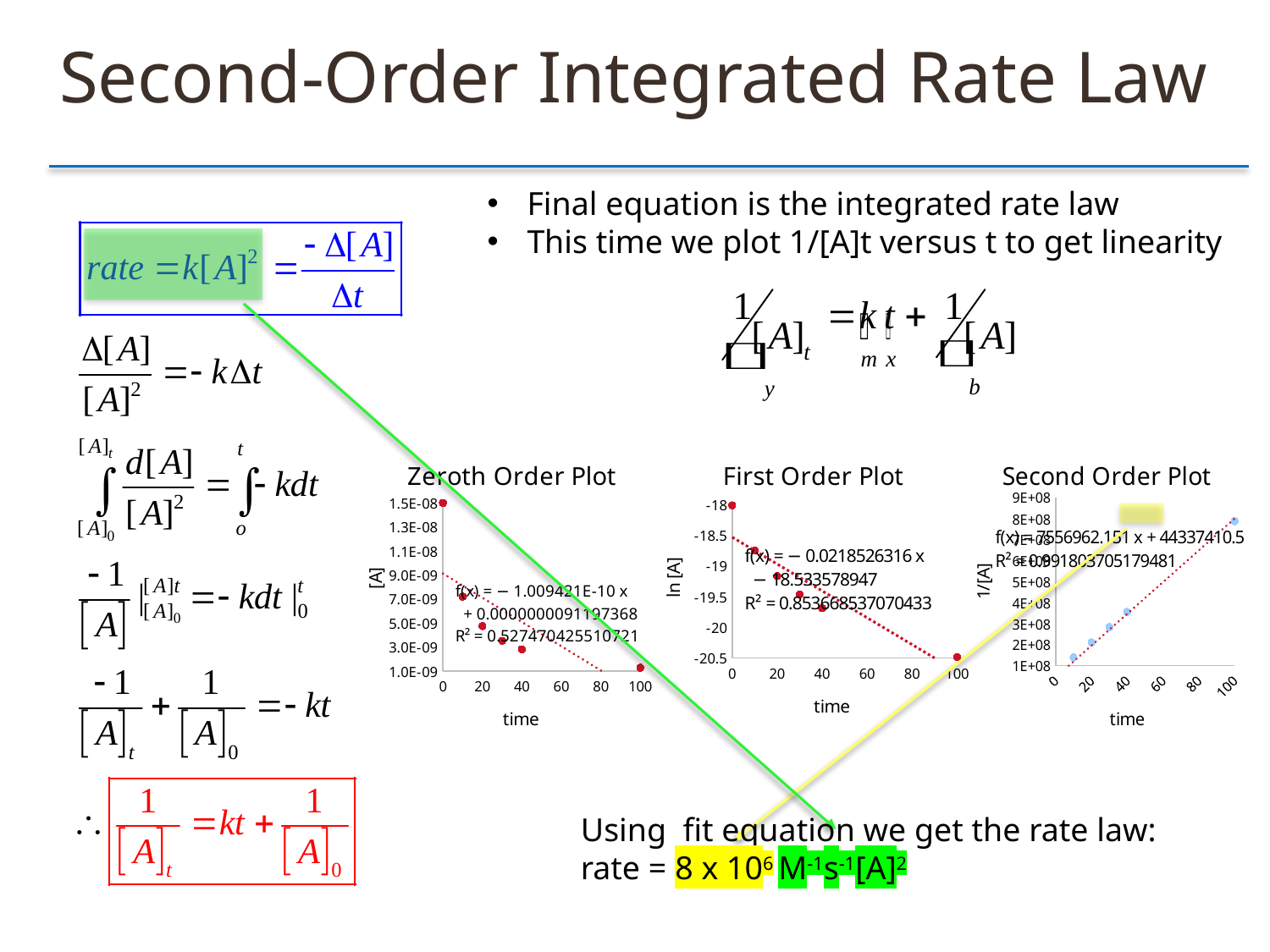
In the First Order Plot, do the ln [A] values rise or fall as time increases? fall In the Second Order Plot, at which time is 1/[A] highest? 100 In the First Order Plot, is the value at time 100 greater or less than -20? less What kind of chart is the Zeroth Order Plot? scatter plot In the Zeroth Order Plot, at which time is [A] highest? 0 In the Zeroth Order Plot, do the [A] values rise or fall as time increases? fall In the Second Order Plot, is the value at time 100 greater or less than 5E+08? greater What is the y-axis label of the Second Order Plot? 1/[A] In the Second Order Plot, which is larger: the value at time 20 or the value at time 100? time 100 In the Second Order Plot, do the 1/[A] values rise or fall as time increases? rise In the Zeroth Order Plot, is the value at time 100 greater or less than 3.0E-09? less What is the R² value shown on the First Order Plot? 0.853668537070433